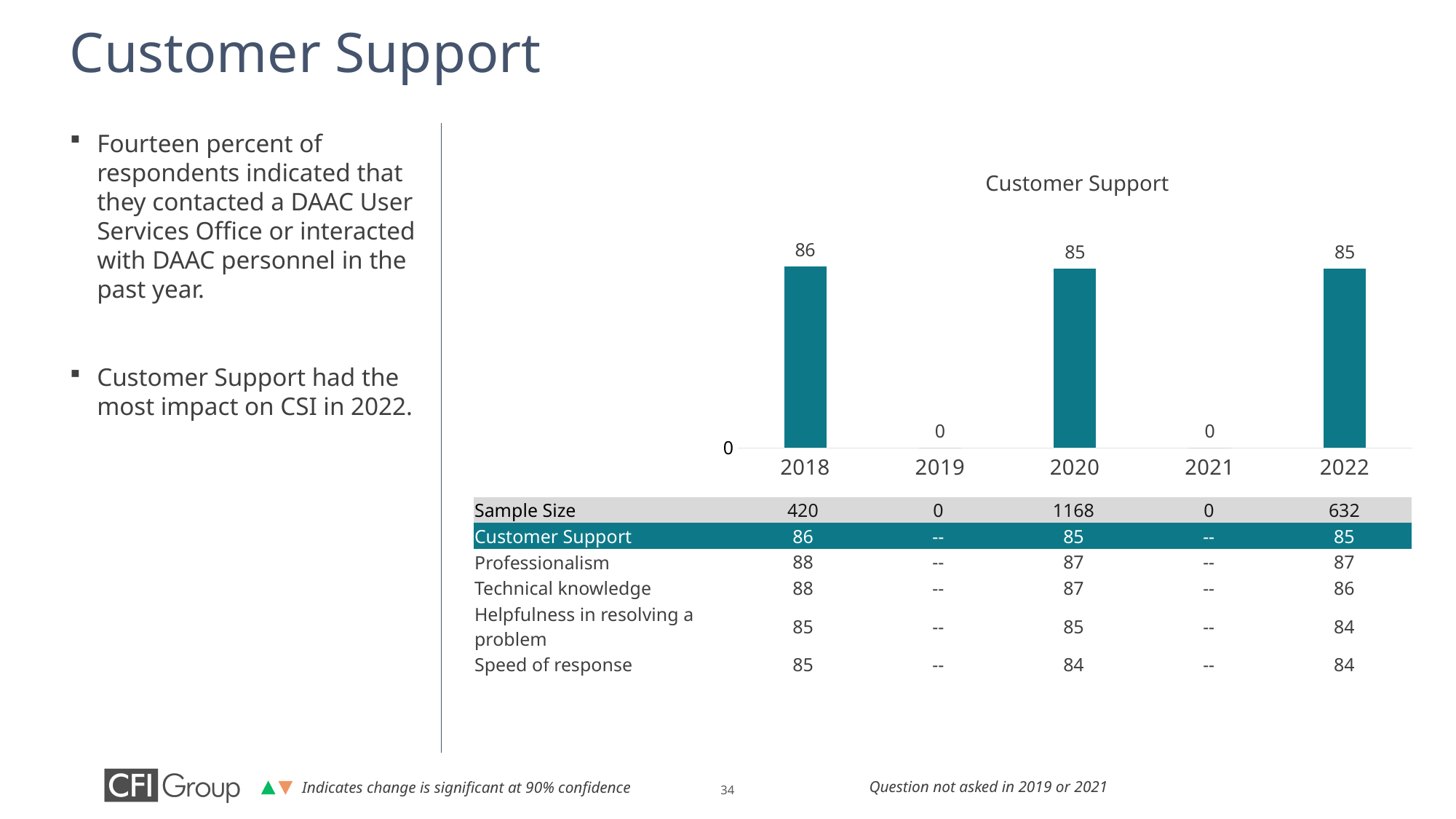
What value is shown for 2019 in the chart? 0 What is the Customer Support score for 2022 in the chart? 85 Which year has the highest Customer Support score in the chart? 2018 What is the Customer Support score for 2018 in the chart? 86 What is the difference between the 2018 and 2020 Customer Support scores? 1 How many years are shown on the x axis of the chart? 5 Is the Customer Support score for 2018 higher or lower than the score for 2022? higher What is the title of the chart? Customer Support What colour are the bars in the chart? teal How many years in the chart have a non-zero Customer Support score? 3 Is the Customer Support score for 2020 greater or less than 0? greater What type of chart is shown on the slide? bar chart